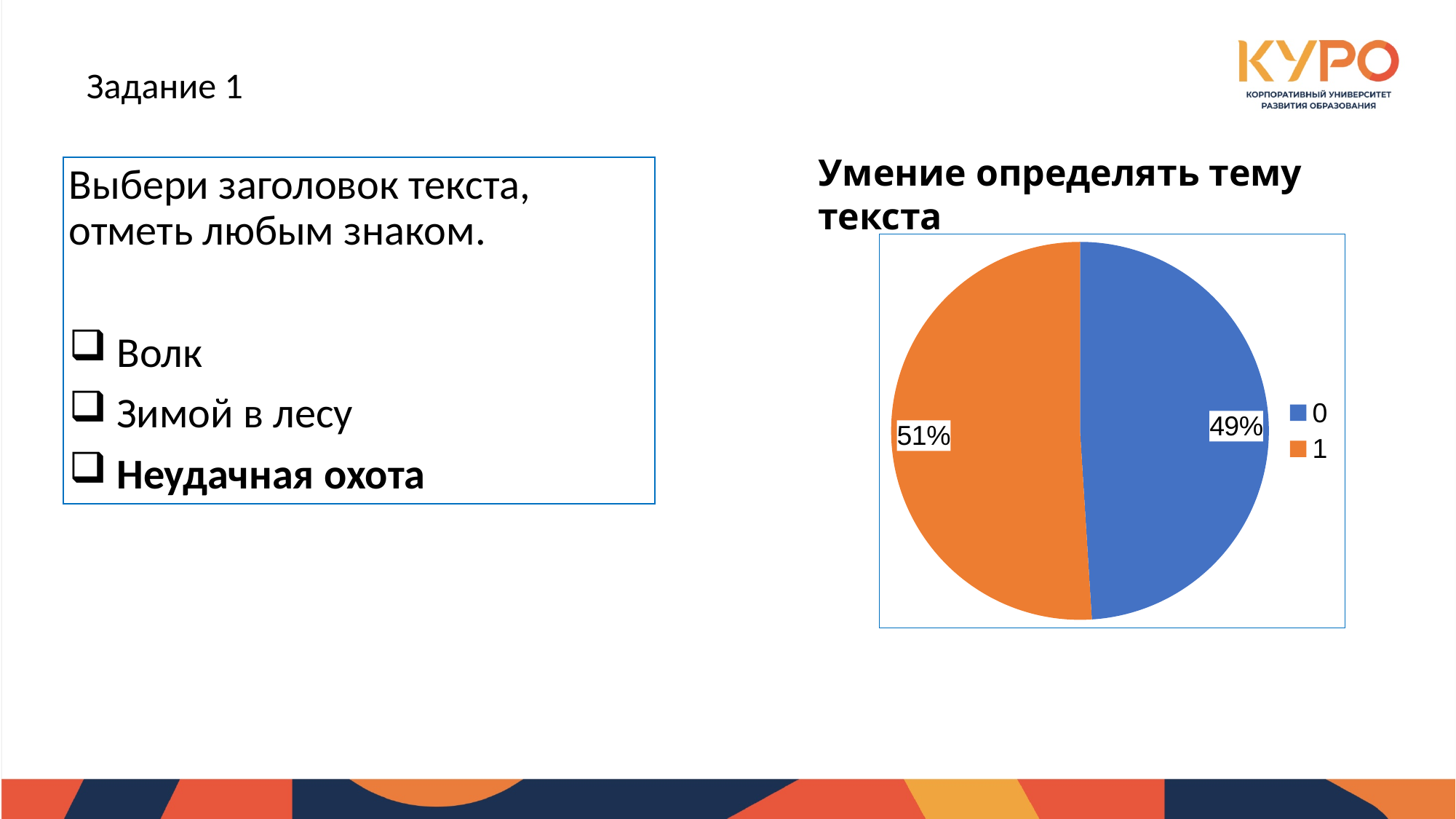
Which category has the larger share in the pie chart, 0 or 1? 1 What percentage does the slice labelled 0 represent in the pie chart? 49% What percentage does the slice labelled 1 represent in the pie chart? 51% Is the share for category 1 greater or less than 50%? greater Which category has the smallest slice in the pie chart? 0 What is the difference in percentage points between the slices for 1 and 0? 2 What is the title shown above the pie chart? Умение определять тему текста Which category has the largest slice in the pie chart? 1 What colour is the slice for category 0 in the pie chart? blue How many slices does the pie chart have? 2 What kind of chart is shown on the slide? pie chart How many entries does the legend of the pie chart list? 2